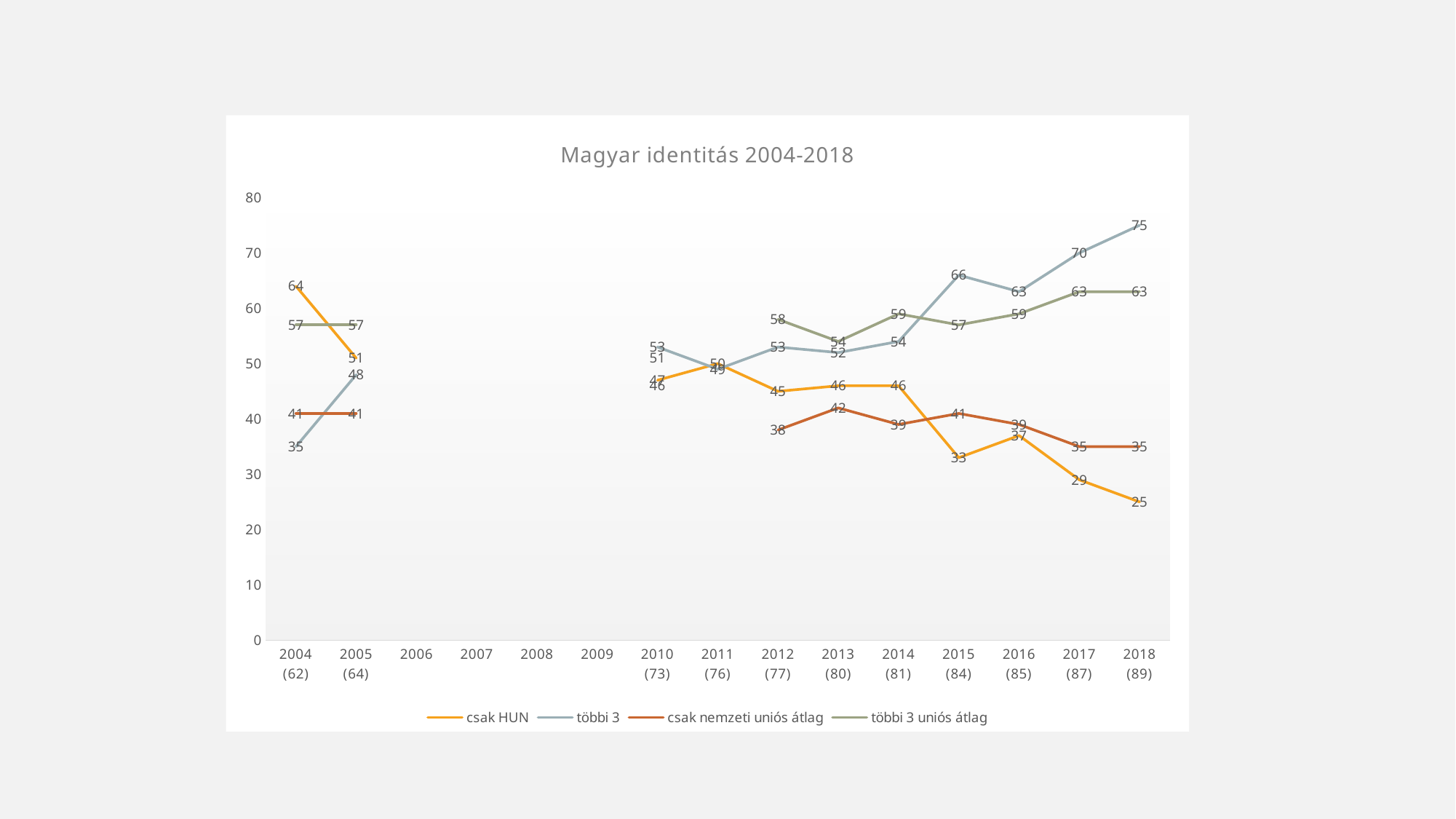
How many series does the legend list? 4 In 2015 (84), which is larger: 'többi 3' or 'csak HUN'? többi 3 What is the value of the 'többi 3' series in 2018 (89)? 75 What is the difference between the 'többi 3' and 'csak HUN' values in 2018 (89)? 50 Does the 'csak HUN' series generally rise or fall from 2010 to 2018? fall What type of chart is shown on the slide? line chart What is the value of the 'csak HUN' series in 2018 (89)? 25 In which year does the 'csak HUN' series have its lowest value? 2018 (89) What is the value of the 'többi 3 uniós átlag' series in 2017 (87)? 63 What is the value of the 'csak HUN' series in 2004 (62)? 64 In which year does the 'többi 3' series reach its highest value? 2018 (89) What is the title of the chart? Magyar identitás 2004-2018